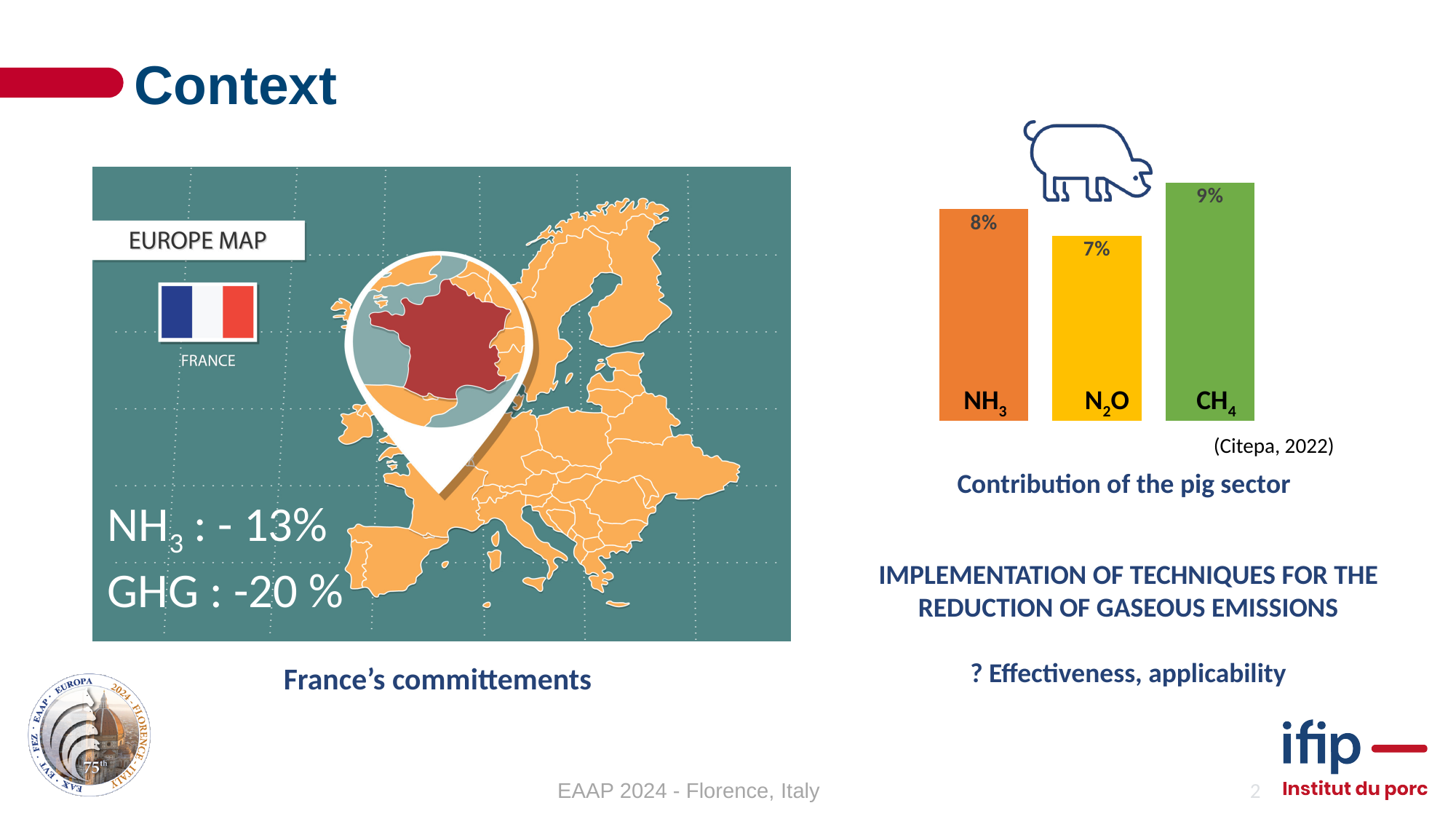
In the 'Contribution of the pig sector' chart, what is the difference between the CH4 and N2O values? 2% What is the value shown for CH4 in the 'Contribution of the pig sector' chart? 9% In the 'Contribution of the pig sector' chart, which is larger, the value for NH3 or the value for CH4? CH4 What type of chart is used to show the contribution of the pig sector? Bar chart Which gas has the lowest contribution in the 'Contribution of the pig sector' chart? N2O How many bars are shown in the 'Contribution of the pig sector' chart? 3 What source is cited below the 'Contribution of the pig sector' chart? (Citepa, 2022) What colour is the CH4 bar in the 'Contribution of the pig sector' chart? Green What is the value shown for N2O in the 'Contribution of the pig sector' chart? 7% Which gas has the highest contribution in the 'Contribution of the pig sector' chart? CH4 What is the value shown for NH3 in the 'Contribution of the pig sector' chart? 8% In the 'Contribution of the pig sector' chart, what is the difference between the NH3 and N2O values? 1%